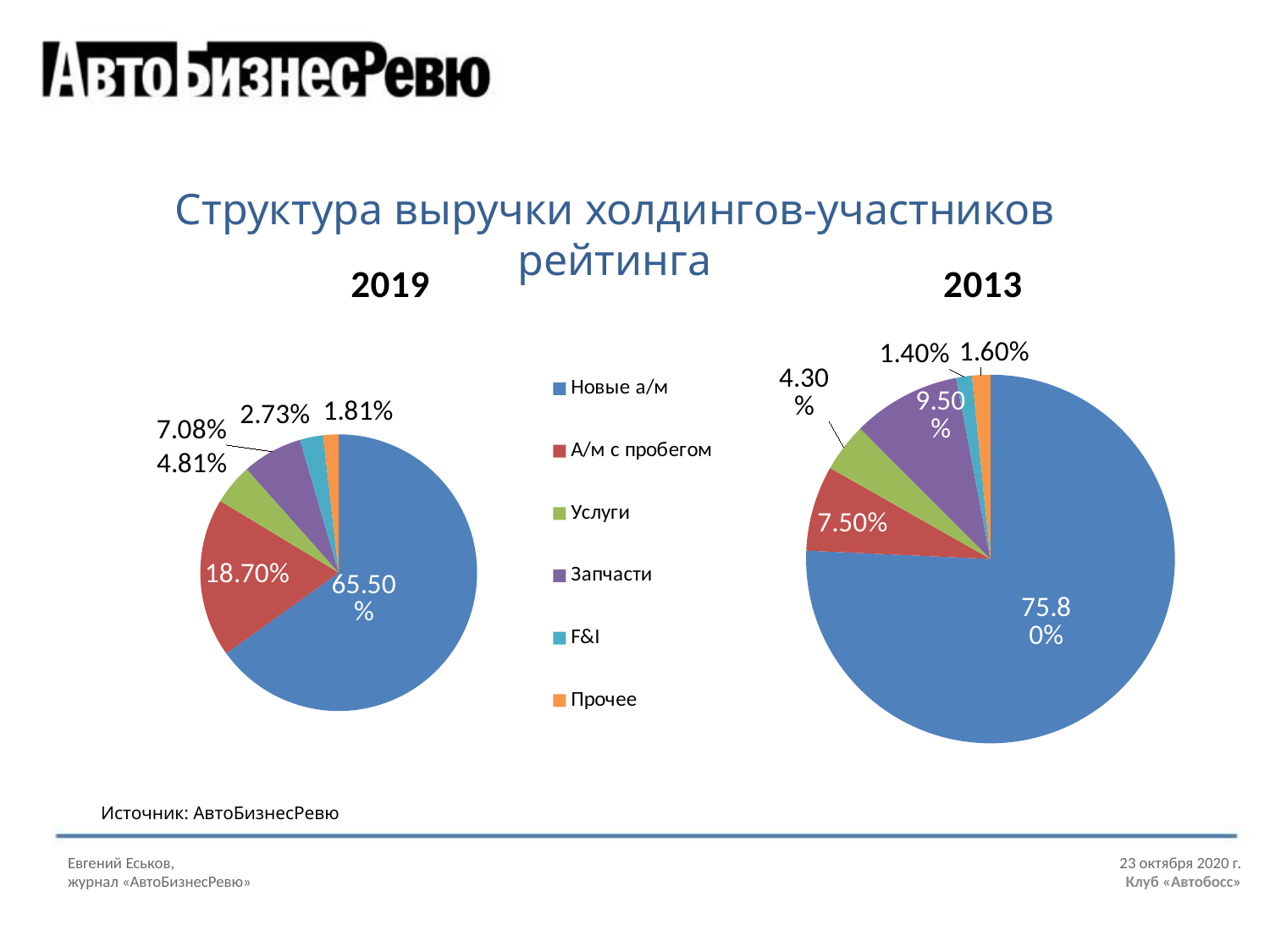
In the 2013 pie chart, which category has the smallest share? F&I In the 2013 pie chart, which category has the largest share? Новые а/м Which is larger: the Услуги share in 2019 or in 2013? 2019 In the 2019 pie chart, which category has the smallest share? Прочее Which colour represents F&I in the legend? Teal (light blue) In the 2013 pie chart, what share does Новые а/м have? 75.80% How many categories does the legend list? 6 What is the difference between the А/м с пробегом share in 2019 and in 2013? 11.20% In the 2019 pie chart, what share does Новые а/м have? 65.50% In the 2013 pie chart, what is the value for Запчасти? 9.50% What type of chart is used on this slide? Pie chart In the 2019 pie chart, what is the value for А/м с пробегом? 18.70%